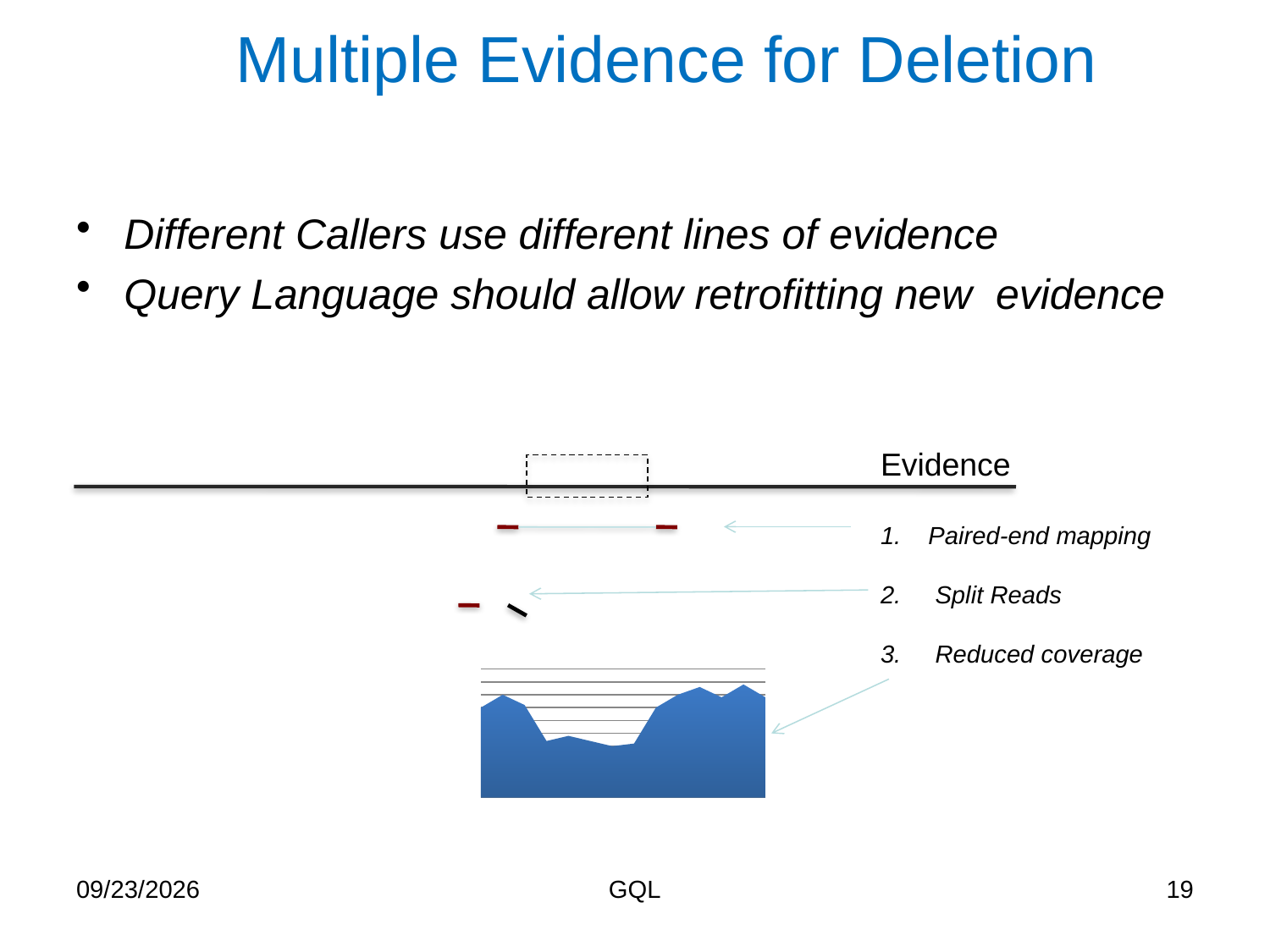
In the blue area chart, is the plotted value in the middle of the chart higher or lower than at the right edge? lower What kind of chart is the blue chart at the bottom of the slide? area chart In the blue area chart, does the plotted value rise or fall from the left edge toward the middle of the chart? fall What colour is the filled area in the area chart? blue Does the area chart on the slide show a legend? No